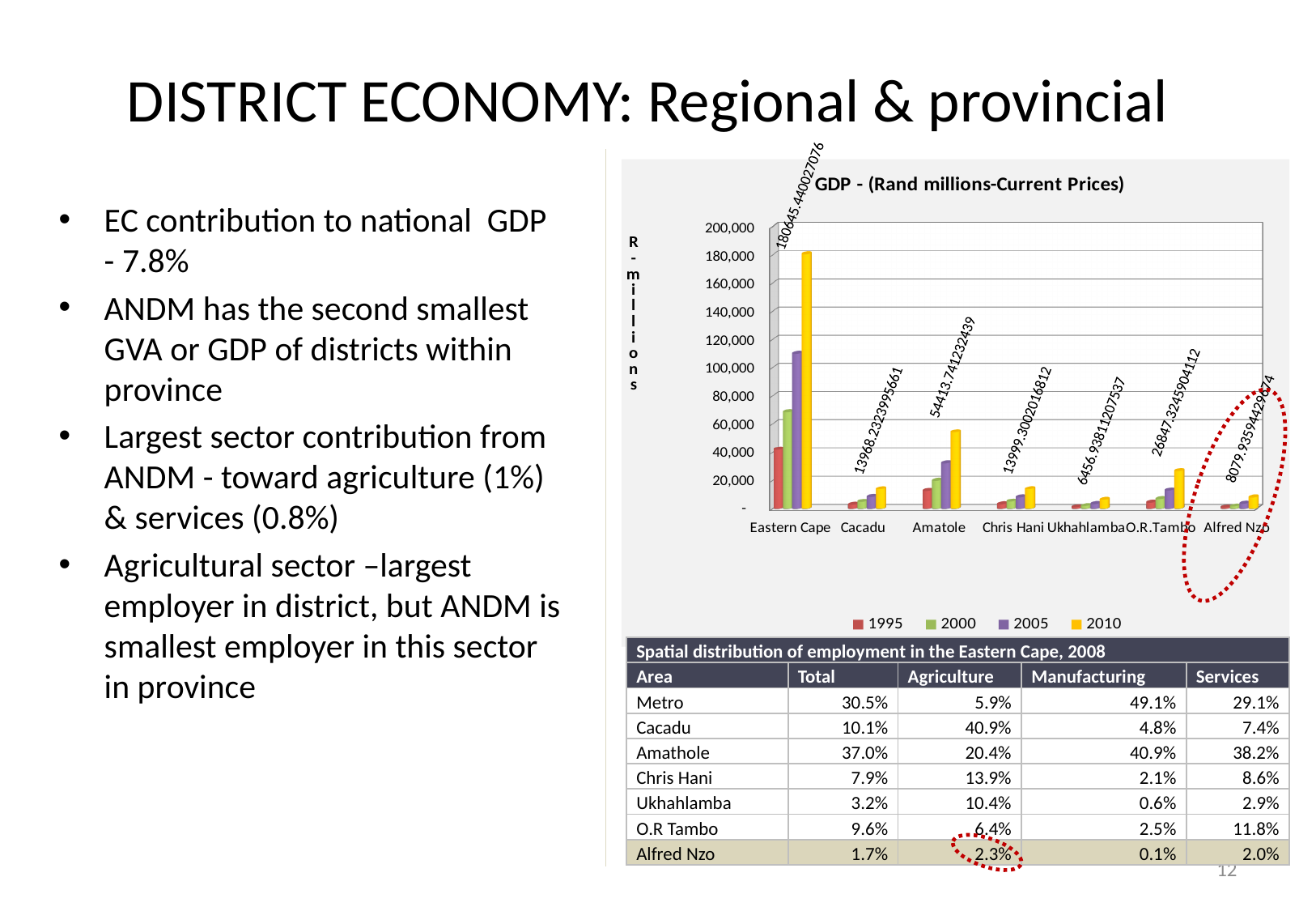
What is the 2010 GDP value labelled for Ukhahlamba? 6456.9381207537 What kind of chart is shown on the slide? bar chart Which area has the lowest 2010 GDP value in the chart? Ukhahlamba How many series does the legend of the GDP chart list? 4 What is the title of the chart on the slide? GDP - (Rand millions-Current Prices) What is the 2010 GDP value labelled for Amatole? 54413.741232439 Is the 2005 GDP value for Eastern Cape greater or less than 80,000? greater How many areas (categories) are shown on the x axis of the GDP chart? 7 Which has the larger 2010 GDP value, Amatole or O.R.Tambo? Amatole Which area has the highest 2010 GDP value in the chart? Eastern Cape Do the GDP values for Eastern Cape rise or fall from 1995 to 2010? rise What is the 2010 GDP value labelled for Eastern Cape? 180645.440027076